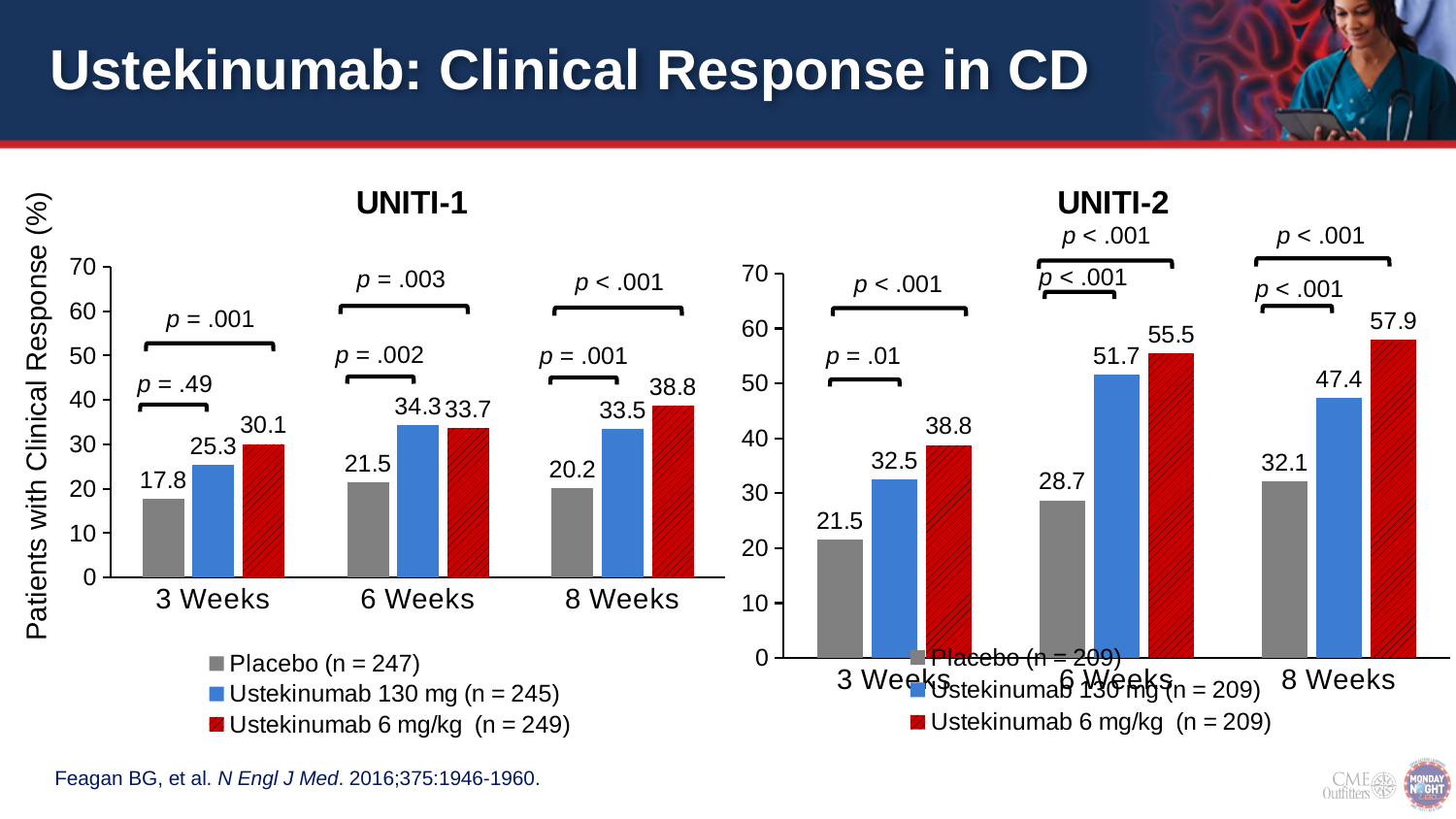
In the UNITI-2 chart, which series has the highest value at 6 Weeks? Ustekinumab 6 mg/kg How many time-point categories are shown on the x axis of the UNITI-1 chart? 3 How many series does the legend of the UNITI-2 chart list? 3 In the UNITI-1 chart, which is larger at 8 Weeks: Ustekinumab 130 mg or Ustekinumab 6 mg/kg? Ustekinumab 6 mg/kg In the UNITI-2 chart, what is the value for Ustekinumab 6 mg/kg at 8 Weeks? 57.9 In the UNITI-1 chart, what is the difference between the Ustekinumab 130 mg and Placebo values at 3 Weeks? 7.5 In the UNITI-2 chart, what is the value for Placebo at 6 Weeks? 28.7 In the UNITI-1 chart, what is the value for Ustekinumab 130 mg at 6 Weeks? 34.3 In the UNITI-1 chart, what is the value for Placebo at 3 Weeks? 17.8 In the UNITI-2 chart, what is the difference between the Ustekinumab 6 mg/kg and Placebo values at 8 Weeks? 25.8 In the UNITI-1 chart, which series has the lowest value at 8 Weeks? Placebo What type of chart is the UNITI-1 chart? Bar chart